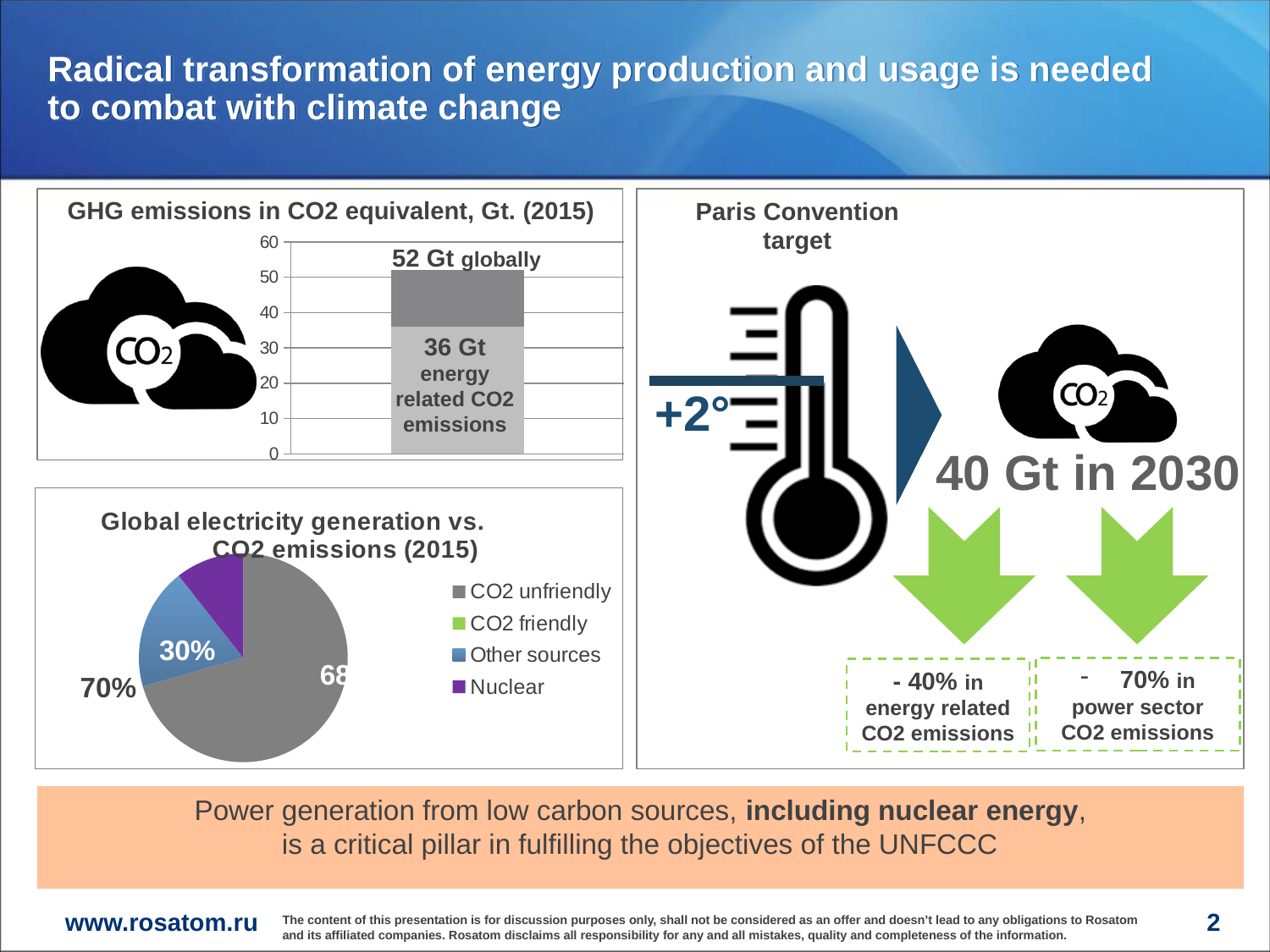
In the 'GHG emissions in CO2 equivalent, Gt. (2015)' chart, what is the value of energy related CO2 emissions? 36 Gt In the 'Global electricity generation vs. CO2 emissions (2015)' pie chart, which category has the largest slice? CO2 unfriendly In the 'Global electricity generation vs. CO2 emissions (2015)' pie chart, which colour represents Nuclear in the legend? purple What kind of chart is 'GHG emissions in CO2 equivalent, Gt. (2015)'? bar chart In the 'GHG emissions in CO2 equivalent, Gt. (2015)' chart, is the global total greater or less than 50? greater What is the maximum value shown on the vertical axis of the 'GHG emissions in CO2 equivalent, Gt. (2015)' chart? 60 What kind of chart is 'Global electricity generation vs. CO2 emissions (2015)'? pie chart In the 'GHG emissions in CO2 equivalent, Gt. (2015)' chart, is the energy related CO2 emissions value greater or less than 40? less How many bars are plotted in the 'GHG emissions in CO2 equivalent, Gt. (2015)' chart? 1 In the 'GHG emissions in CO2 equivalent, Gt. (2015)' chart, what is the difference between the global total and the energy related CO2 emissions? 16 Gt How many entries does the legend of the 'Global electricity generation vs. CO2 emissions (2015)' chart list? 4 In the 'GHG emissions in CO2 equivalent, Gt. (2015)' chart, what is the total global GHG emissions value shown on the bar? 52 Gt